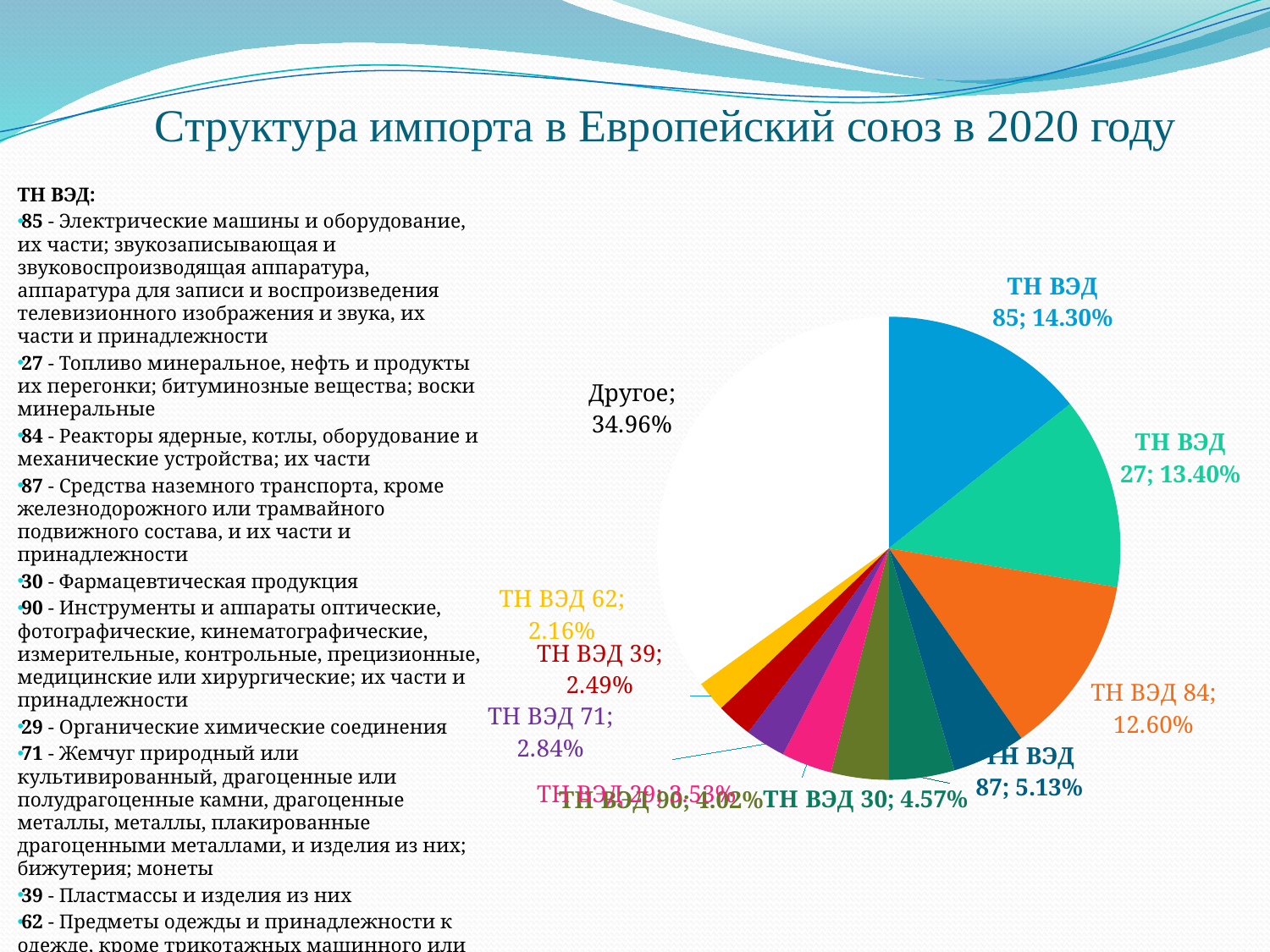
What share is labelled 'Другое' (Other)? 34.96% What share of imports does ТН ВЭД 85 account for? 14.30% What value is labelled for ТН ВЭД 30? 4.57% What is the share of ТН ВЭД 87? 5.13% Which has a larger share, ТН ВЭД 84 or ТН ВЭД 87? ТН ВЭД 84 What kind of chart is shown on the slide? pie chart What is the value shown for ТН ВЭД 27? 13.40% What is the difference between the shares of ТН ВЭД 85 and ТН ВЭД 27? 0.90% What percentage is shown for ТН ВЭД 84? 12.60% Which of the labelled ТН ВЭД categories has the smallest share? ТН ВЭД 62 What percentage is shown for ТН ВЭД 62? 2.16% Which slice of the pie is the largest? Другое